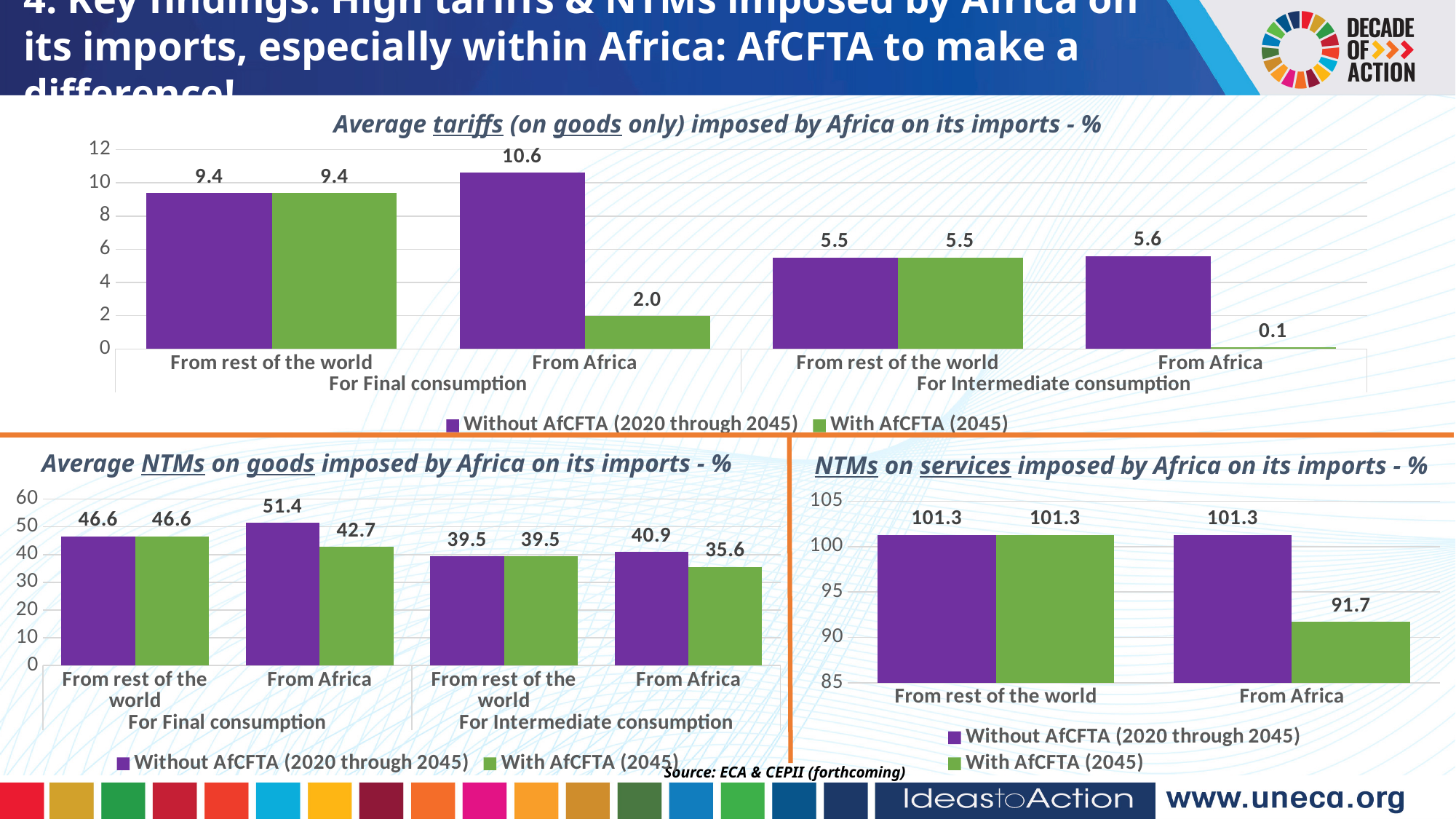
In the 'NTMs on services' chart, which is larger for 'From Africa': the 'Without AfCFTA (2020 through 2045)' value or the 'With AfCFTA (2045)' value? Without AfCFTA (2020 through 2045) In the 'Average tariffs (on goods only)' chart, what is the value for 'From Africa' under 'For Final consumption' in the 'With AfCFTA (2045)' series? 2.0 In the 'NTMs on services' chart, what is the 'With AfCFTA (2045)' value for 'From Africa'? 91.7 How many series does the legend of the 'Average tariffs (on goods only)' chart list? 2 In the 'Average NTMs on goods' chart, which bar has the lowest value? From Africa, For Intermediate consumption, With AfCFTA (2045) In the 'Average NTMs on goods' chart, what is the difference between the 'Without AfCFTA' and 'With AfCFTA' values for 'From Africa' under 'For Intermediate consumption'? 5.3 In the 'Average tariffs (on goods only)' chart, what is the 'Without AfCFTA (2020 through 2045)' value for 'From Africa' under 'For Intermediate consumption'? 5.6 What type of chart is the 'NTMs on services imposed by Africa on its imports' chart? Bar chart In the 'Average tariffs (on goods only)' chart, which bar has the highest value? From Africa, For Final consumption, Without AfCFTA (2020 through 2045) In the 'Average NTMs on goods' chart, what is the 'With AfCFTA (2045)' value for 'From Africa' under 'For Final consumption'? 42.7 In the 'Average NTMs on goods' chart, is the 'Without AfCFTA' value for 'From Africa' under 'For Final consumption' greater or less than 50? greater In the 'Average tariffs (on goods only)' chart, what is the difference between the 'Without AfCFTA' and 'With AfCFTA' values for 'From Africa' under 'For Final consumption'? 8.6